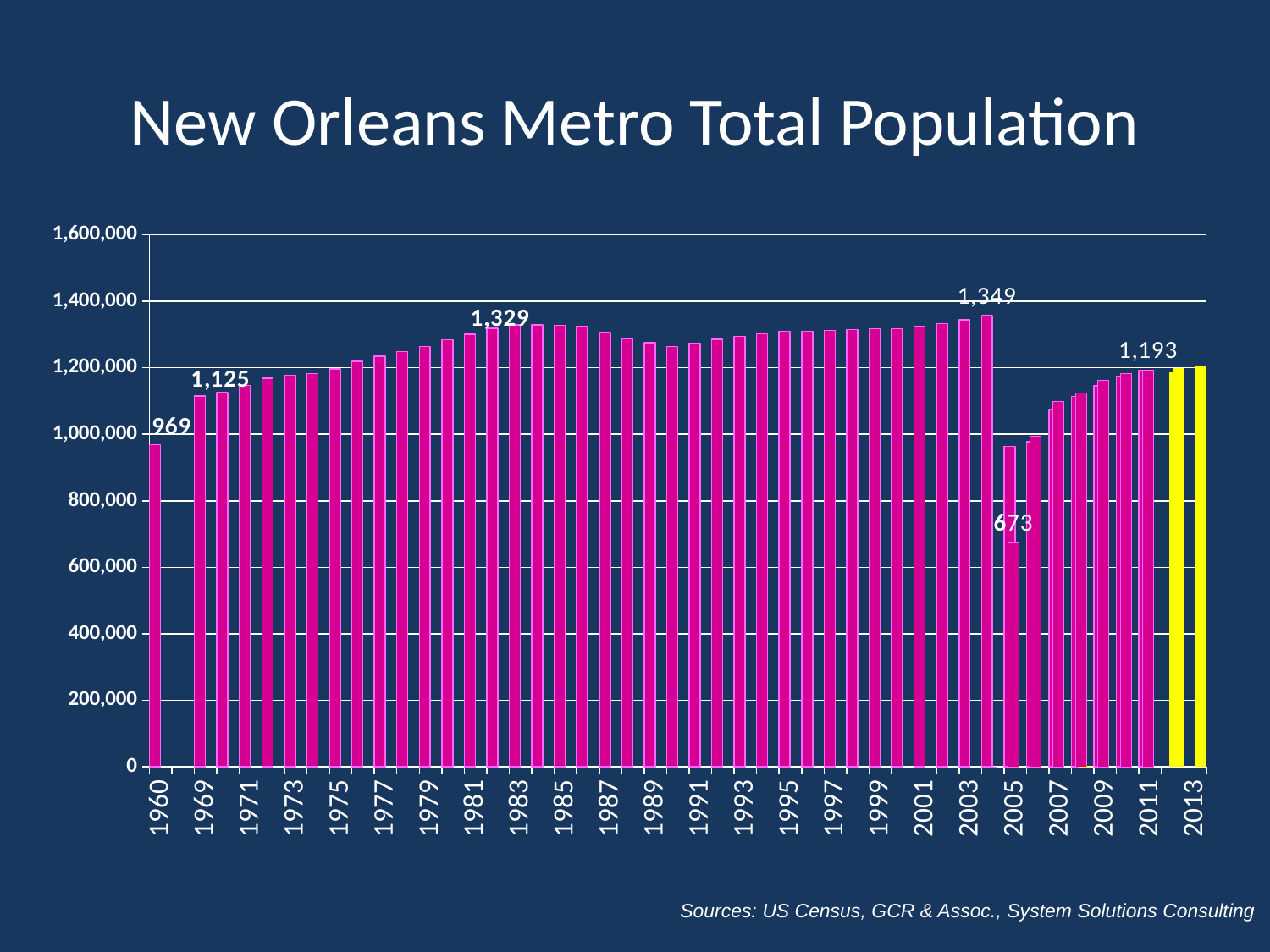
Which year has the larger value, 1960 or 2005? 1960 Is the value for 2013 greater or less than 1,000,000? greater Which year has the lowest bar on the chart? 2005 Do the values rise or fall from 1969 to 1983? rise What kind of chart is shown on the slide? bar chart What is the title of the chart? New Orleans Metro Total Population What value is labeled for 2005? 673 What is the highest value labeled on the chart? 1,349 What value is labeled for 1960? 969 Is the value for 1960 greater or less than 1,000,000? less